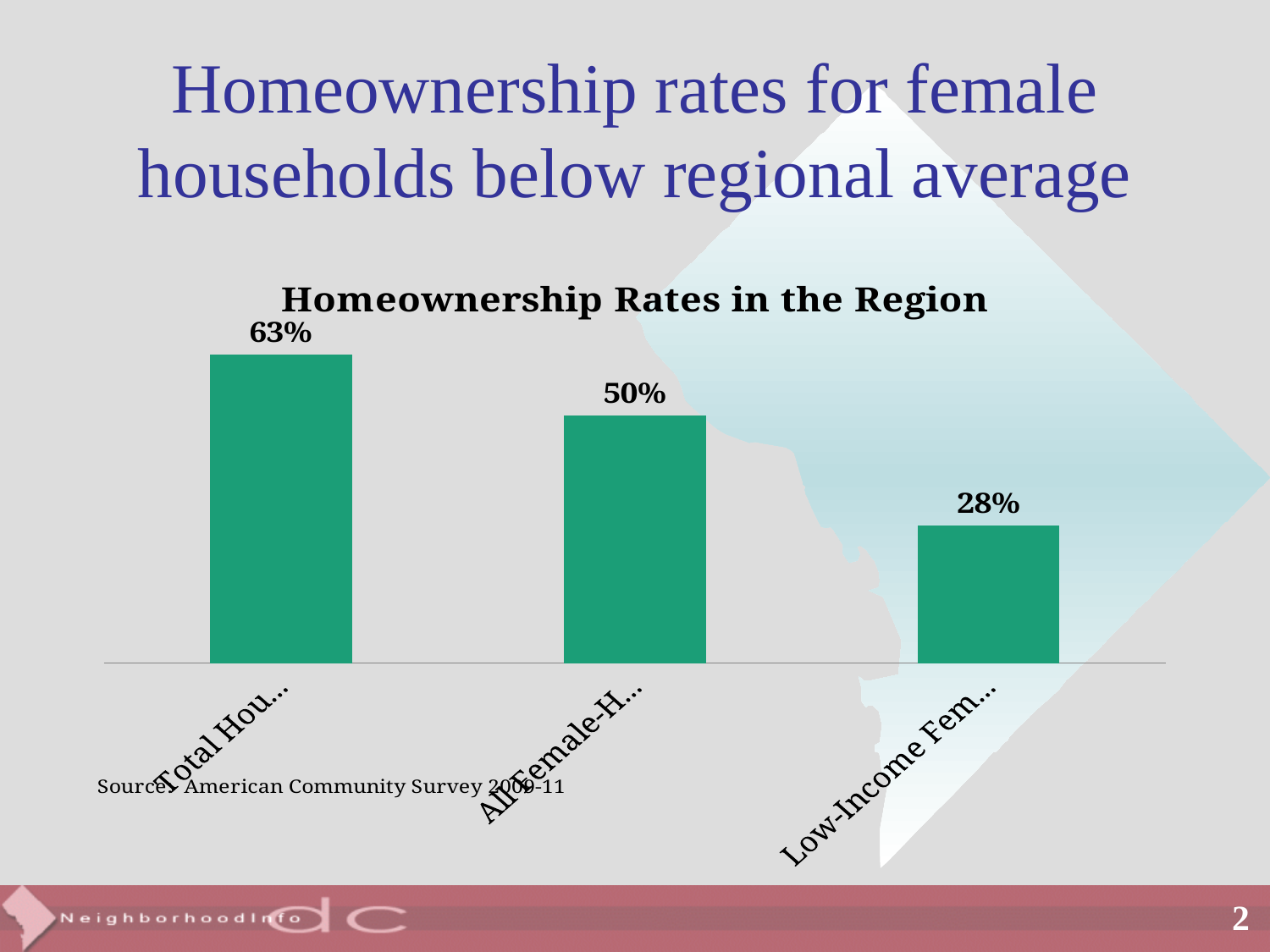
Which bar has the highest value? Total Hou... (leftmost bar) How many bars are plotted in the chart? 3 What type of chart is shown on the slide? bar chart What is the value of the middle bar, labelled "All Female-H..."? 50% Which bar has the lowest value? Low-Income Fem... (rightmost bar) What is the title of the chart? Homeownership Rates in the Region What is the value of the first (leftmost) bar, labelled "Total Hou..."? 63% What is the value of the rightmost bar, labelled "Low-Income Fem..."? 28% Which is larger, the middle bar (All Female-H...) or the rightmost bar (Low-Income Fem...)? the middle bar (All Female-H...) What is the difference between the leftmost bar (63%) and the rightmost bar (28%)? 35% Do the bar values rise or fall from left to right across the chart? fall What is the difference between the leftmost bar (63%) and the middle bar (50%)? 13%